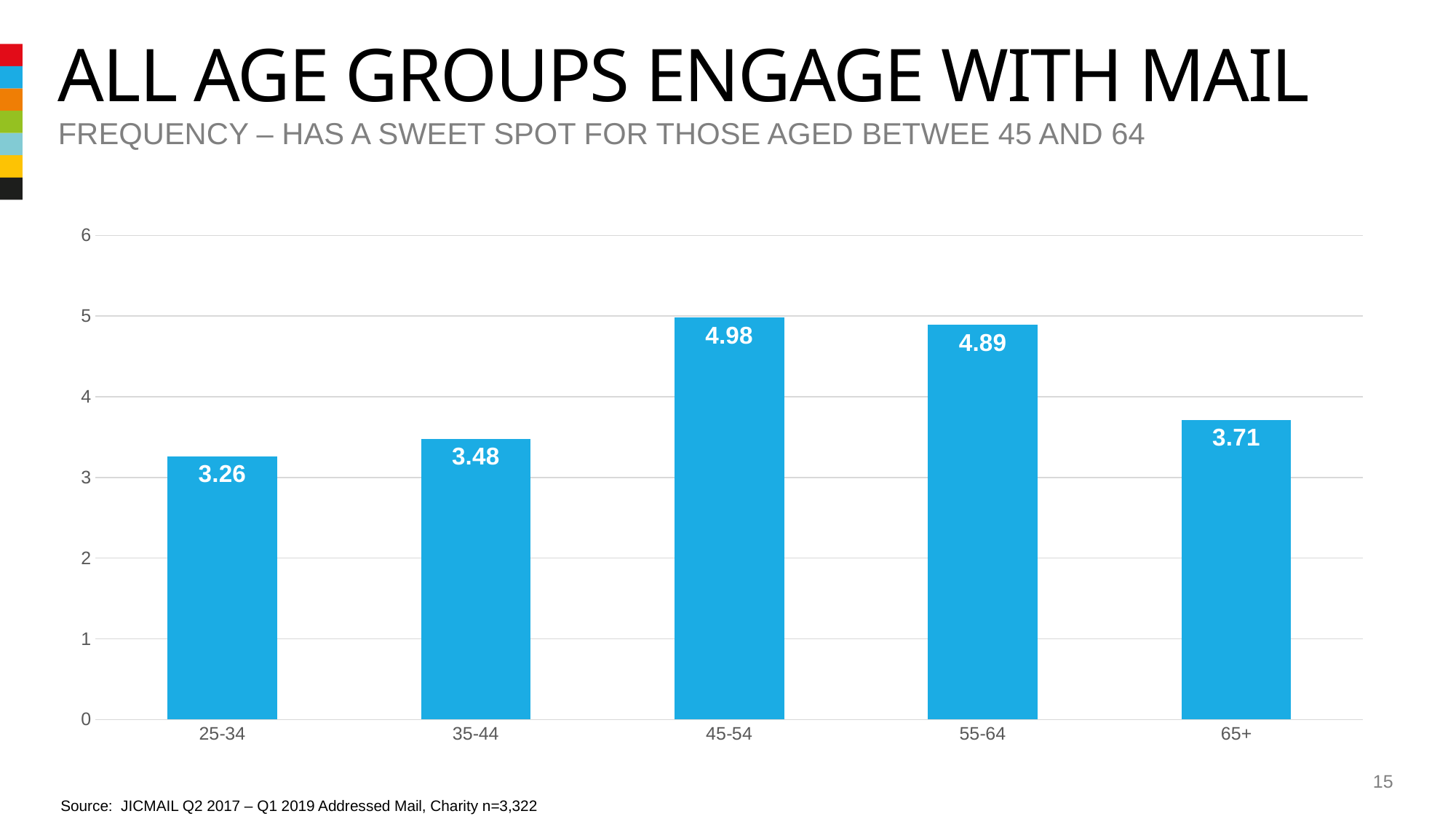
What is the value for the 45-54 age group? 4.98 What kind of chart is shown on the slide? Bar chart Which age group has the lowest value? 25-34 What is the source cited at the bottom of the slide? JICMAIL Q2 2017 – Q1 2019 Addressed Mail, Charity n=3,322 Which is larger, the value for 35-44 or the value for 65+? 65+ What is the difference between the values for 45-54 and 25-34? 1.72 What is the value for the 65+ age group? 3.71 Which age group has the highest value? 45-54 Is the value for 55-64 greater or less than 4? greater What is the difference between the values for 55-64 and 65+? 1.18 What is the value for the 25-34 age group? 3.26 How many age groups are shown on the chart? 5